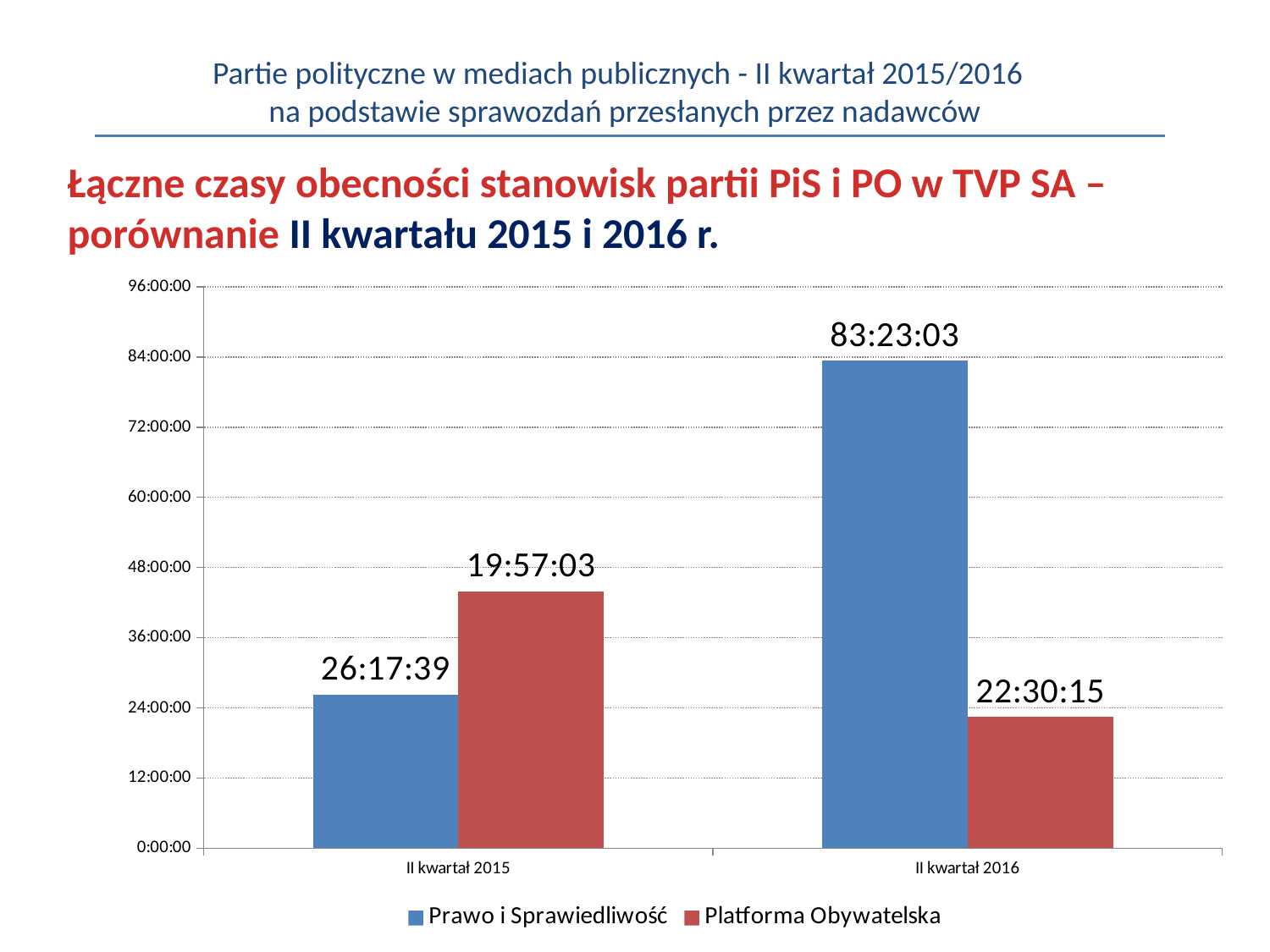
How many series does the legend list? 2 In II kwartał 2016, which party has the larger value, Prawo i Sprawiedliwość or Platforma Obywatelska? Prawo i Sprawiedliwość What is the value for Prawo i Sprawiedliwość in II kwartał 2016? 83:23:03 What is the value for Platforma Obywatelska in II kwartał 2016? 22:30:15 What is the value for Prawo i Sprawiedliwość in II kwartał 2015? 26:17:39 How many categories are shown on the x axis? 2 What kind of chart is shown on the slide? bar chart What is the difference between Prawo i Sprawiedliwość and Platforma Obywatelska in II kwartał 2016? 60:52:48 Which bar has the highest value in the chart? Prawo i Sprawiedliwość, II kwartał 2016 What is the data label shown for Platforma Obywatelska in II kwartał 2015? 19:57:03 Is the value for Prawo i Sprawiedliwość in II kwartał 2016 greater or less than 72:00:00? greater Is the value for Platforma Obywatelska in II kwartał 2016 greater or less than 24:00:00? less